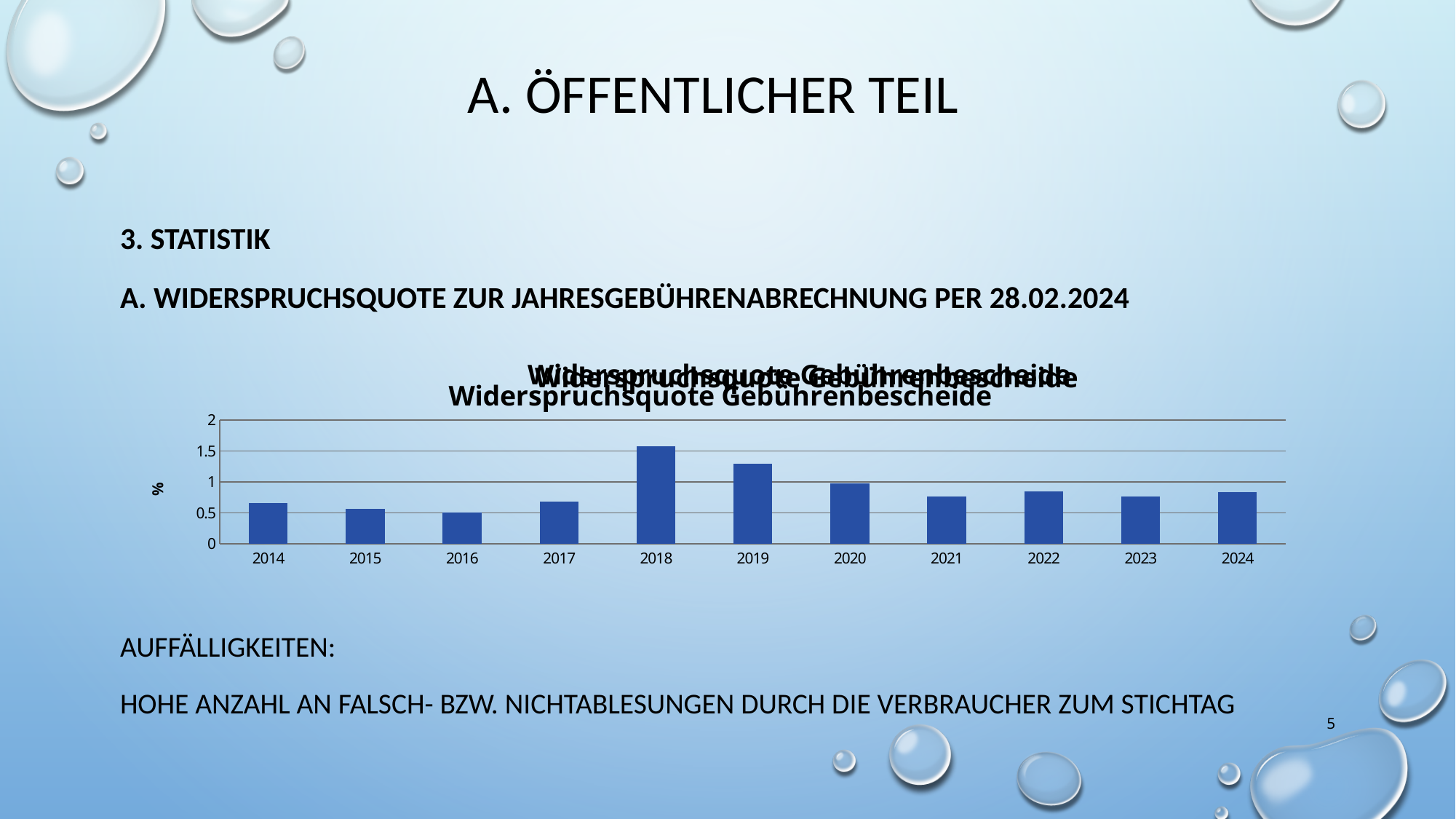
Which year has the highest Widerspruchsquote in the chart? 2018 Is the value for 2018 greater or less than 1? greater Which is larger, the value for 2019 or the value for 2020? 2019 What kind of chart is shown on the slide? bar chart Do the values rise or fall from 2018 to 2021? fall How many years are shown on the x axis of the chart? 11 What is the title of the chart? Widerspruchsquote Gebührenbescheide Is the value for 2014 greater or less than 0.5? greater Is the value for 2016 greater or less than 1? less Which is larger, the value for 2018 or the value for 2019? 2018